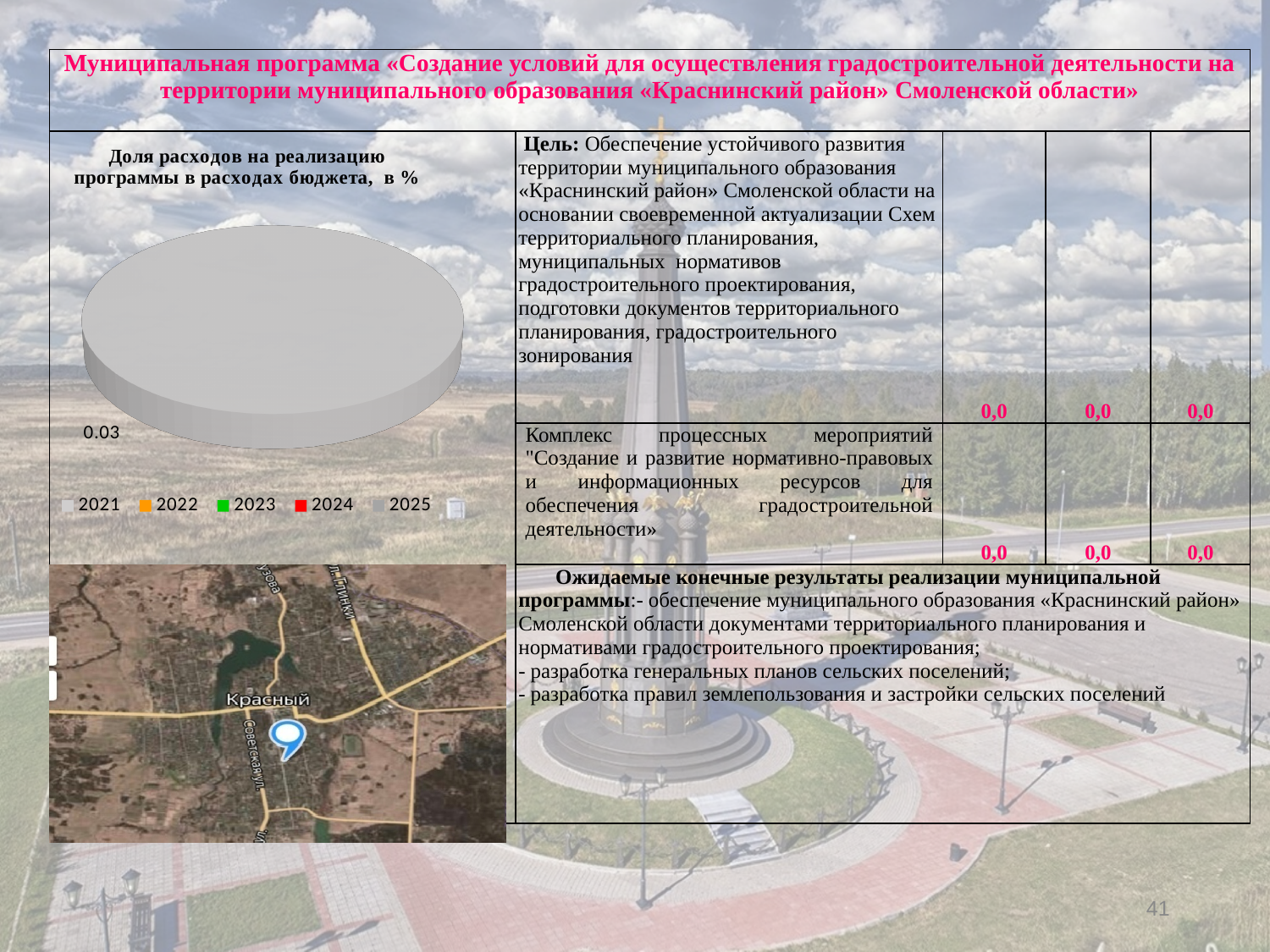
What kind of chart is shown on the slide? pie chart How many distinct slices are visible in the pie chart? 1 Which years are listed in the legend of the pie chart? 2021, 2022, 2023, 2024, 2025 What value is printed as a data label on the pie chart? 0.03 What is the title of the pie chart? Доля расходов на реализацию программы в расходах бюджета, в % How many entries does the legend of the pie chart list? 5